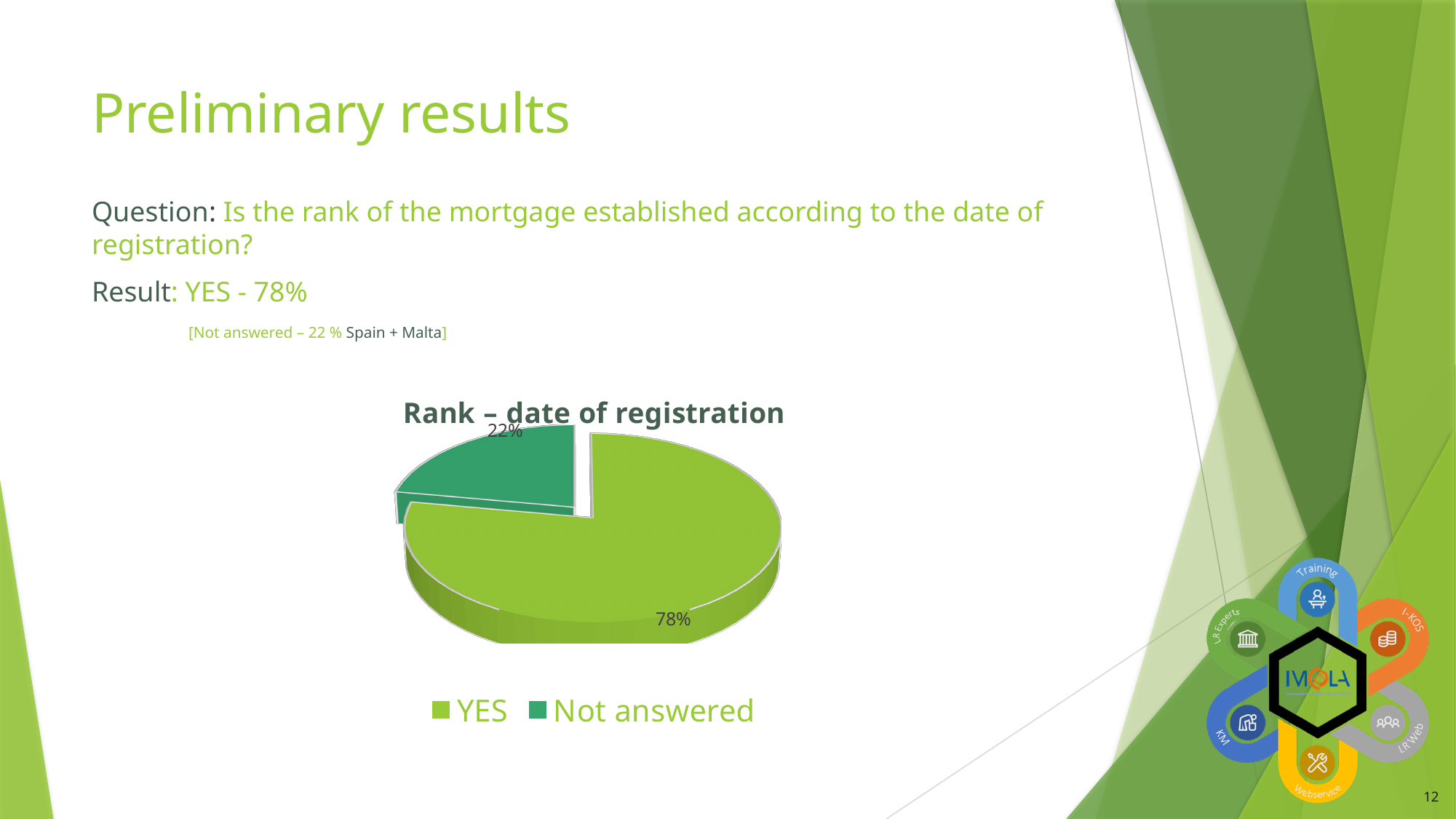
What type of chart is shown on the slide? Pie chart How many slices does the pie chart have? 2 What share of the pie does the Not answered slice represent? 22% What colour is the Not answered slice in the pie chart? Dark green (teal) Which slice of the pie is the largest? YES What is the total of the two slices shown in the pie chart? 100% Which slice of the pie is the smallest? Not answered What is the title of the chart? Rank – date of registration Which is larger, the YES slice or the Not answered slice? YES What is the difference in percentage points between the YES slice and the Not answered slice? 56 How many entries does the legend list? 2 What share of the pie does the YES slice represent? 78%